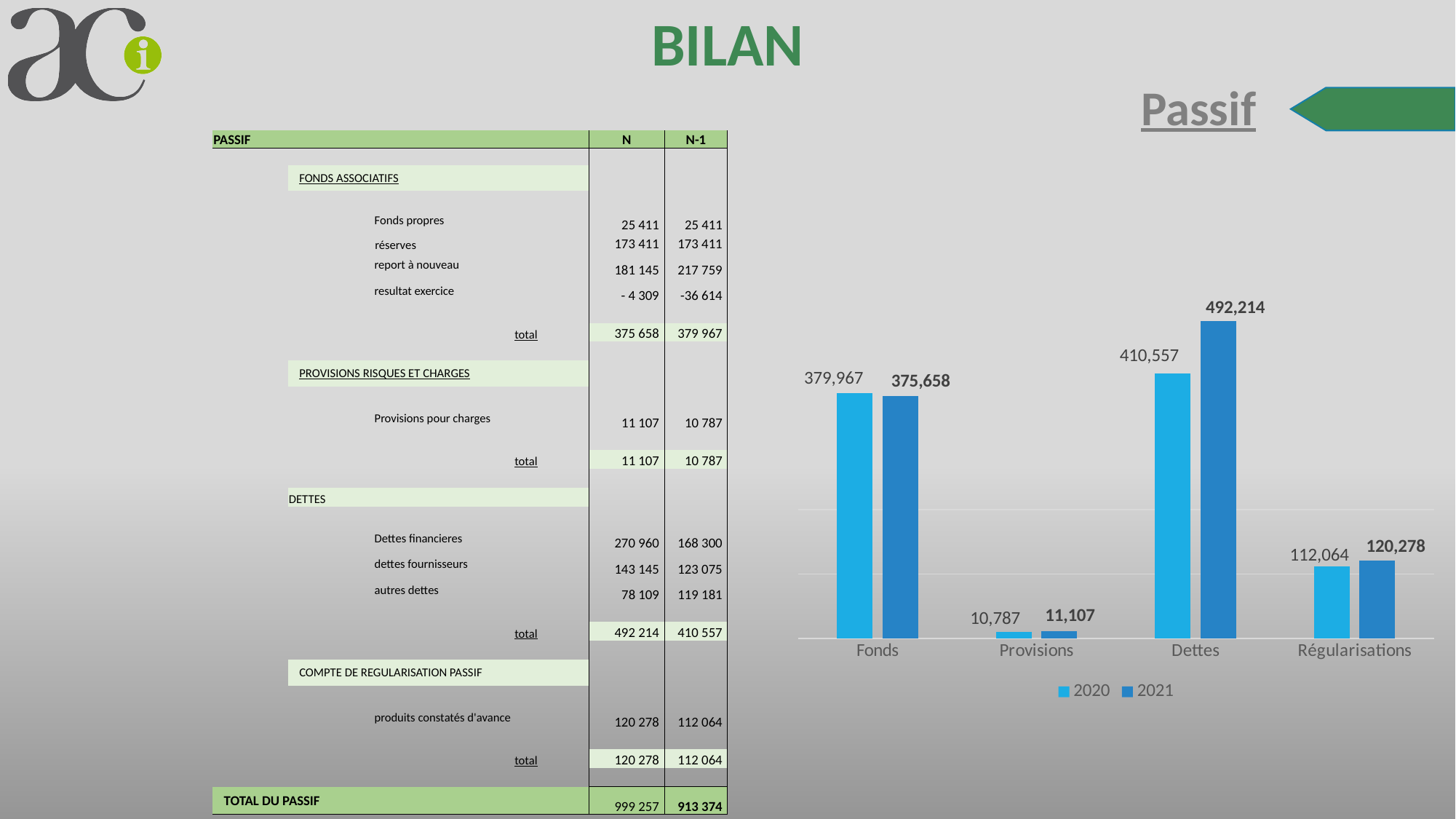
What is the value for Fonds in the 2020 series? 379,967 How many categories are shown on the x axis of the chart? 4 What is the difference between the 2021 and 2020 values for Dettes? 81,657 For Régularisations, which series has the larger value, 2020 or 2021? 2021 Which category has the lowest value in the 2020 series? Provisions What is the value for Provisions in the 2021 series? 11,107 What kind of chart is shown on the slide? bar chart How many series does the chart legend list? 2 What is the value for Régularisations in the 2020 series? 112,064 What is the value for Dettes in the 2021 series? 492,214 Which category has the highest value in the 2021 series? Dettes What is the difference between the 2020 and 2021 values for Fonds? 4,309